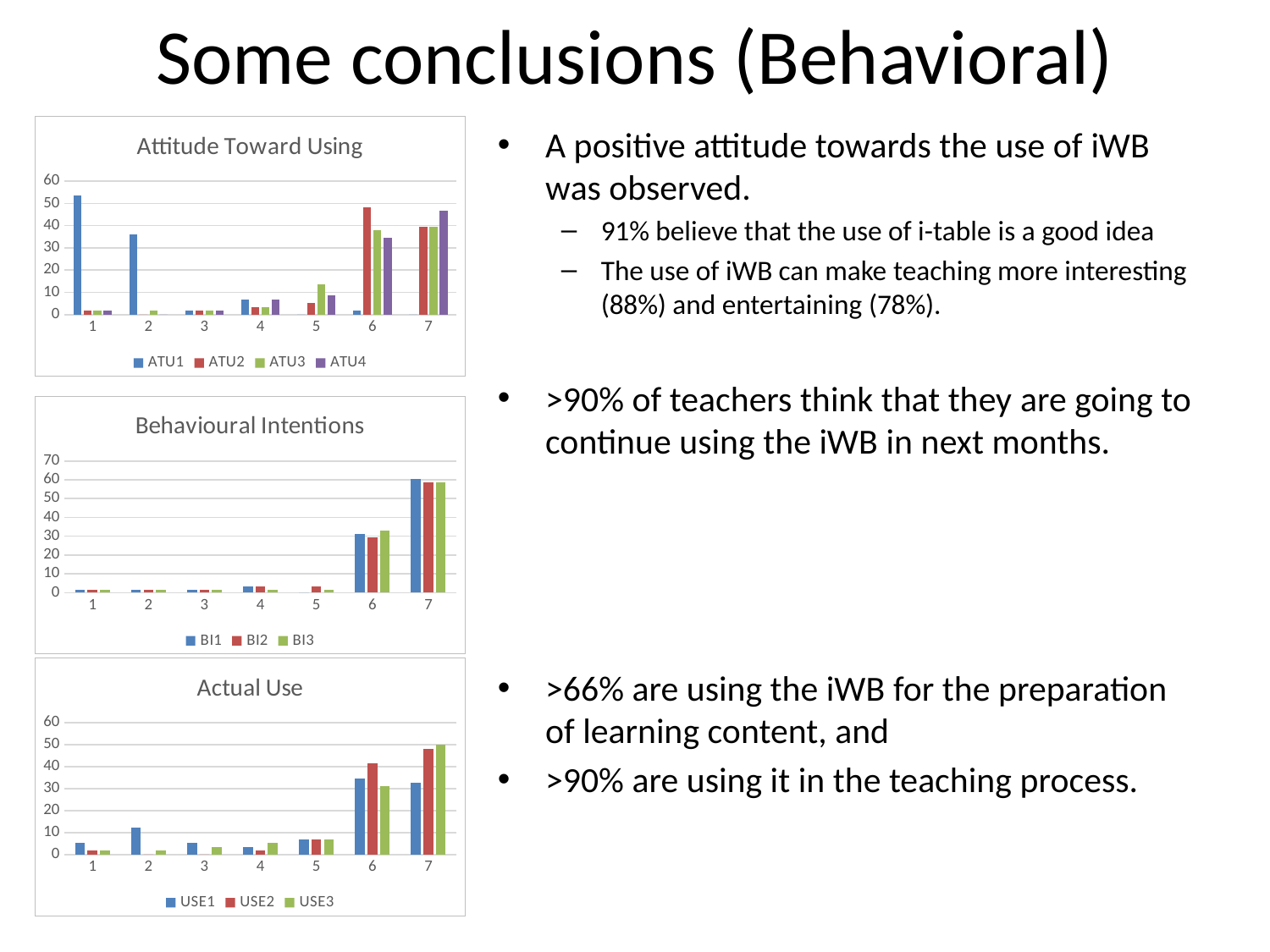
In the Behavioural Intentions chart, is the value of BI1 for category 7 greater or less than 50? greater In the Attitude Toward Using chart, for which category is ATU1 highest? 1 In the Attitude Toward Using chart, is the value of ATU1 for category 1 greater or less than 50? greater In the Attitude Toward Using chart, how many series does the legend list? 4 What type of chart is the Actual Use chart? bar chart In the Behavioural Intentions chart, is the value of BI1 for category 6 greater or less than 40? less In the Actual Use chart, which is larger for category 6: USE1 or USE2? USE2 In the Behavioural Intentions chart, how many categories are shown on the x axis? 7 In the Attitude Toward Using chart, for which category is ATU4 highest? 7 In the Behavioural Intentions chart, how many series does the legend list? 3